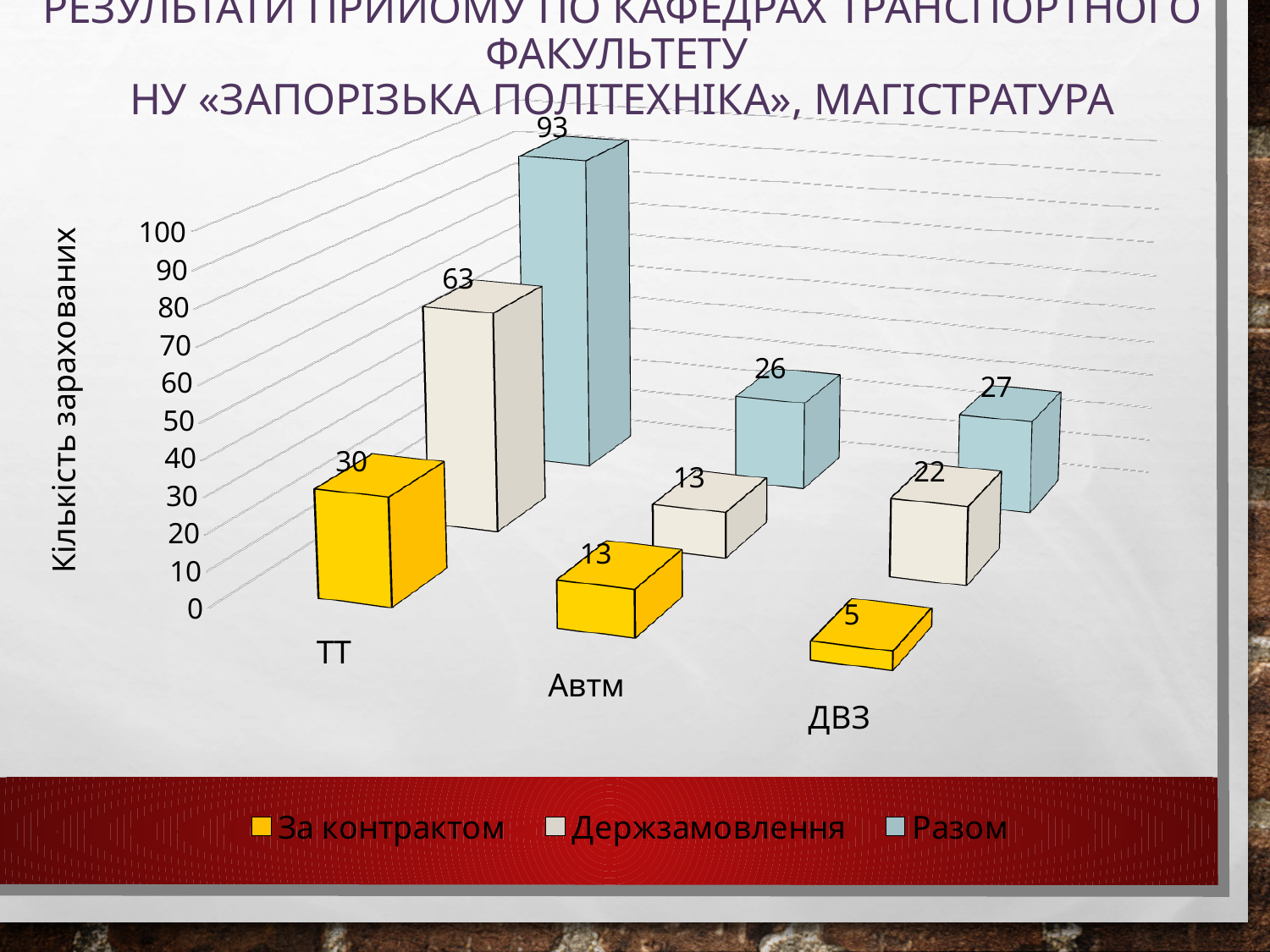
What is the value for Разом for Автм? 26 What kind of chart is shown on the slide? bar chart Which is larger: the Разом value for ДВЗ or the Разом value for Автм? ДВЗ What is the value for Держзамовлення for ДВЗ? 22 Is the value for Разом for ТТ greater or less than 90? greater What is the value for За контрактом for ТТ? 30 What is the difference between the Держзамовлення values for ТТ and Автм? 50 How many series does the legend list? 3 What is the label of the vertical axis? Кількість зарахованих How many categories are shown on the x axis? 3 Which category has the lowest value for За контрактом? ДВЗ Which category has the highest value for Разом? ТТ